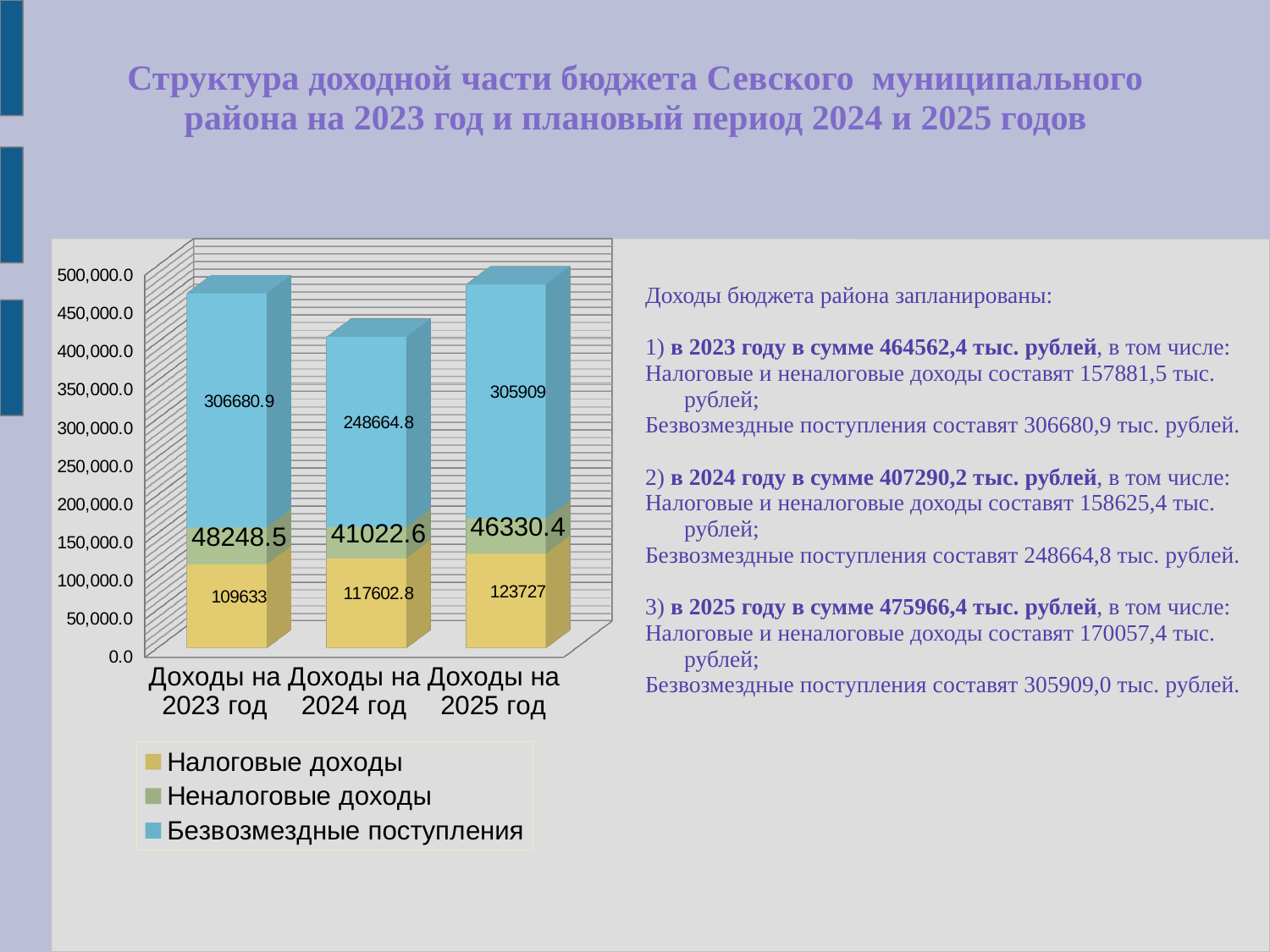
Which year has the highest value of Налоговые доходы? Доходы на 2025 год What is the value of Налоговые доходы for Доходы на 2024 год? 117602.8 How many categories (years) are plotted on the x axis of the chart? 3 What is the difference between Налоговые доходы for 2025 and for 2023? 14094 Which is larger: Неналоговые доходы for 2023 or for 2024? 2023 (48248.5) Which series is shown in blue in the chart legend? Безвозмездные поступления How many series does the chart legend list? 3 What is the value of Неналоговые доходы for Доходы на 2025 год? 46330.4 Which year has the lowest value of Безвозмездные поступления? Доходы на 2024 год What is the value of Безвозмездные поступления for Доходы на 2023 год? 306680.9 What is the total of the stacked bar for Доходы на 2024 год? 407290.2 What type of chart is shown on the slide? Stacked bar chart